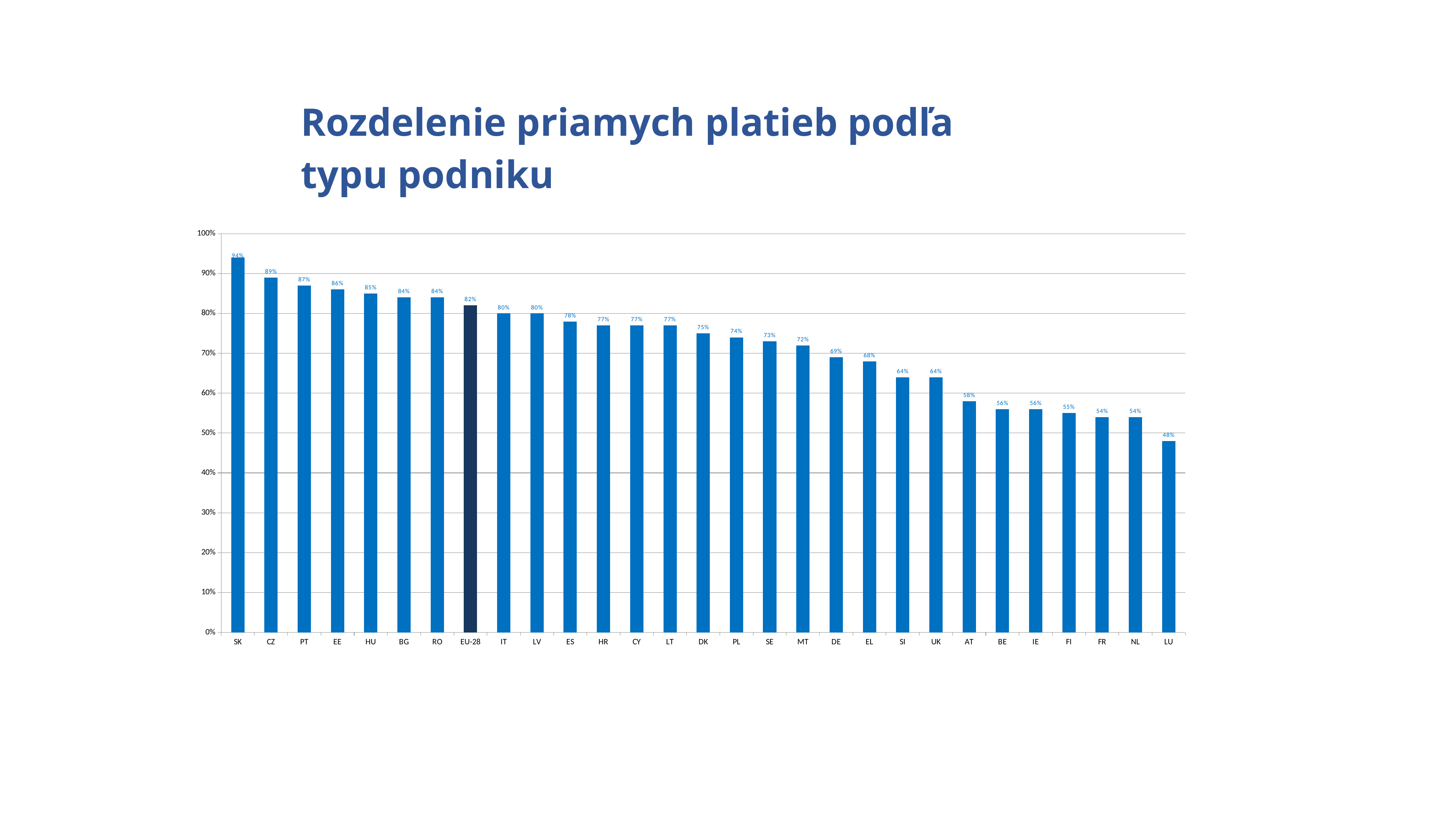
Do the values rise or fall from left to right along the x axis? fall Which category has the lowest value? LU What kind of chart is shown on the slide? bar chart Which category has the highest value? SK What is the difference between the values for SK and LU? 46% What is the difference between the values for CZ and EU-28? 7% What is the value for EU-28? 82% How many categories are shown on the x axis? 29 Which is larger, the value for PL or the value for AT? PL What is the value for DE? 69% What is the value for SK? 94% Is the value for MT greater or less than 60%? greater